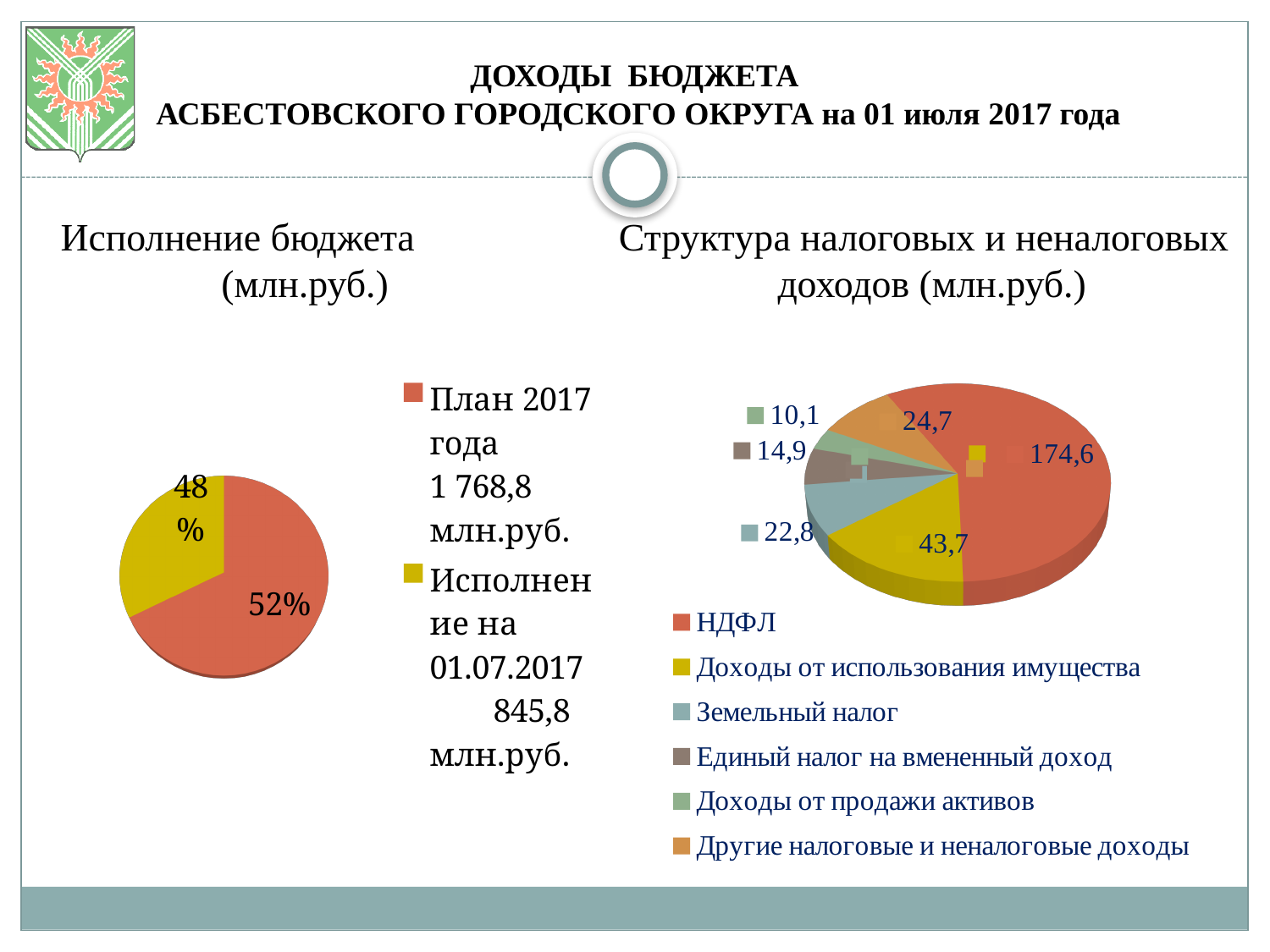
How many slices does the chart titled "Структура налоговых и неналоговых доходов (млн.руб.)" have? 6 In the chart titled "Структура налоговых и неналоговых доходов (млн.руб.)", which category has the largest value? НДФЛ In the chart titled "Структура налоговых и неналоговых доходов (млн.руб.)", which is larger: Единый налог на вмененный доход or Земельный налог? Земельный налог What kind of chart is the chart titled "Исполнение бюджета (млн.руб.)"? Pie chart In the chart titled "Исполнение бюджета (млн.руб.)", what share of the pie is labelled for Исполнение на 01.07.2017? 48% In the chart titled "Структура налоговых и неналоговых доходов (млн.руб.)", which category has the smallest value? Доходы от продажи активов In the chart titled "Исполнение бюджета (млн.руб.)", what share of the pie is labelled for План 2017 года? 52% In the chart titled "Структура налоговых и неналоговых доходов (млн.руб.)", what is the value for Другие налоговые и неналоговые доходы? 24,7 In the chart titled "Структура налоговых и неналоговых доходов (млн.руб.)", what is the value for НДФЛ? 174,6 In the chart titled "Структура налоговых и неналоговых доходов (млн.руб.)", what is the difference between the values for НДФЛ and Доходы от использования имущества? 130,9 In the chart titled "Структура налоговых и неналоговых доходов (млн.руб.)", what colour is the slice for НДФЛ? Red In the chart titled "Структура налоговых и неналоговых доходов (млн.руб.)", what is the value for Земельный налог? 22,8